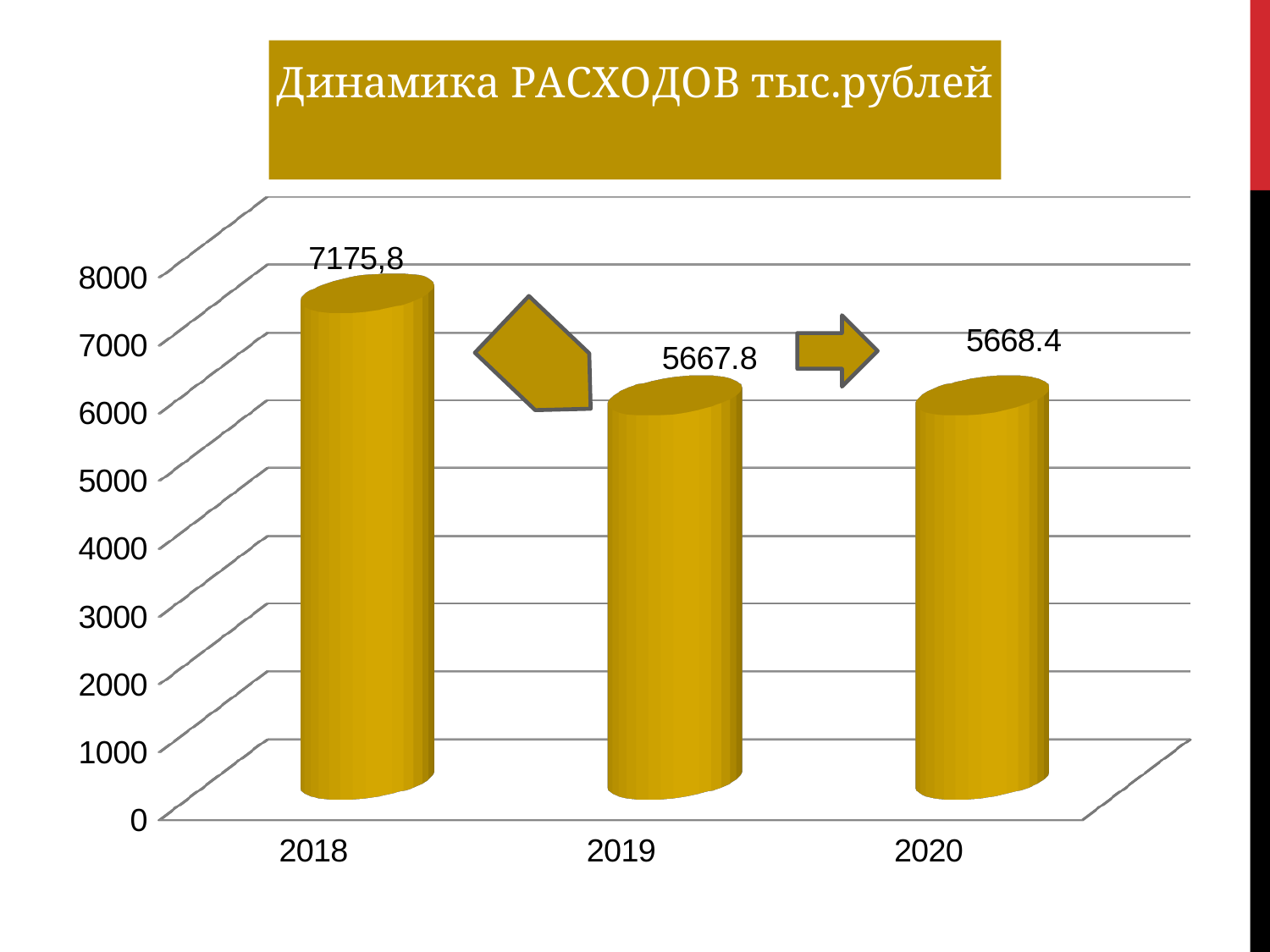
What is the value for 2020? 5668.4 Do the values rise or fall from 2018 to 2019? fall What is the difference between the values for 2018 and 2019? 1508 What kind of chart is shown on the slide? bar chart Which year has the highest value? 2018 Which is larger, the value for 2018 or the value for 2020? 2018 What is the difference between the values for 2020 and 2019? 0.6 How many years are shown on the x axis? 3 Is the value for 2019 greater or less than 6000? less What is the value for 2018? 7175,8 What is the value for 2019? 5667.8 Is the value for 2018 greater or less than 7000? greater